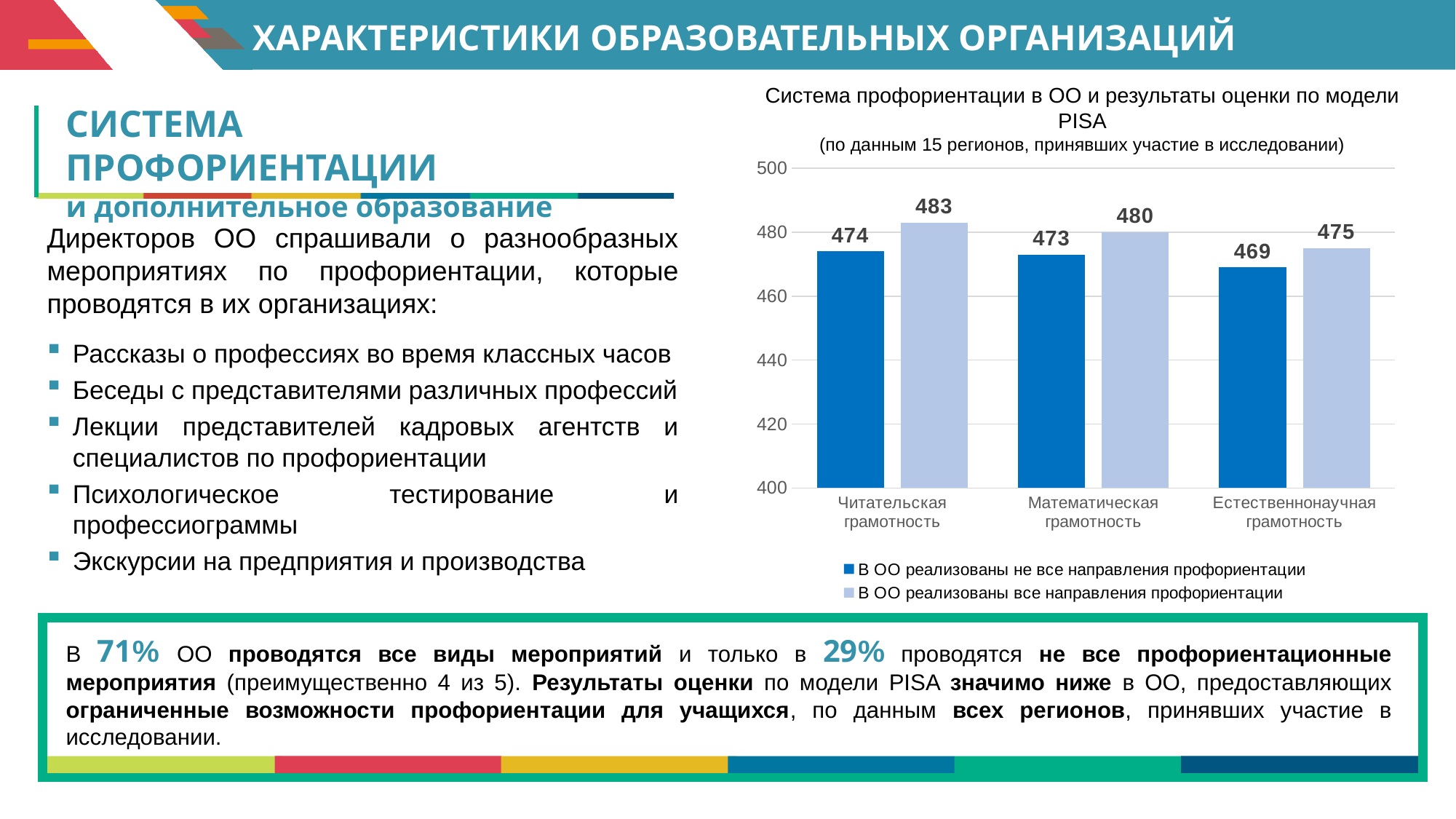
What is the value for Читательская грамотность in the series 'В ОО реализованы все направления профориентации'? 483 What kind of chart is shown on the slide? bar chart For Естественнонаучная грамотность, which series has the larger value? В ОО реализованы все направления профориентации Is the value for Естественнонаучная грамотность in the series 'В ОО реализованы не все направления профориентации' greater or less than 480? less What is the value for Математическая грамотность in the series 'В ОО реализованы все направления профориентации'? 480 How many series does the chart legend list? 2 What is the difference between the two series for Математическая грамотность? 7 Which category has the highest value in the series 'В ОО реализованы все направления профориентации'? Читательская грамотность How many categories are shown on the x axis of the chart? 3 What is the value for Естественнонаучная грамотность in the series 'В ОО реализованы не все направления профориентации'? 469 What is the difference between the two series for Читательская грамотность? 9 Which category has the lowest value in the series 'В ОО реализованы не все направления профориентации'? Естественнонаучная грамотность